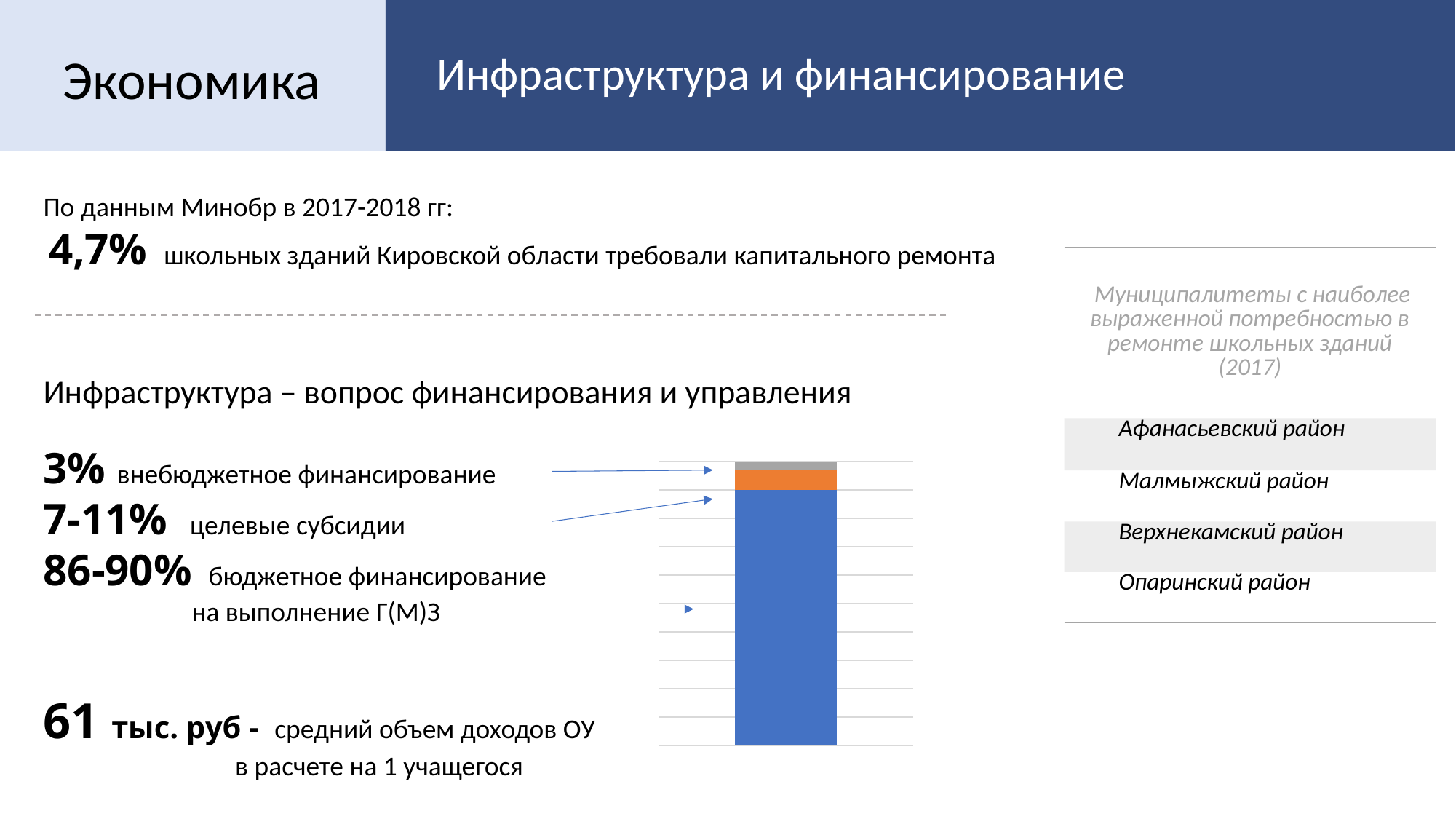
According to the annotation pointing to the blue segment of the bar, what share is бюджетное финансирование на выполнение Г(М)З? 86-90% Is the blue segment of the bar larger or smaller than the orange segment? larger What colour is the segment representing бюджетное финансирование in the chart? blue Which segment of the stacked bar is the largest? the blue segment (бюджетное финансирование) How many segments make up the stacked bar in the chart? 3 What kind of chart is shown on the slide? stacked bar chart Which segment is at the top of the stacked bar? the gray segment (внебюджетное финансирование) Which segment of the stacked bar is the smallest? the gray segment (внебюджетное финансирование) According to the annotation pointing to the orange segment of the bar, what share is целевые субсидии? 7-11% According to the annotation pointing to the top (gray) segment of the bar, what share is внебюджетное финансирование? 3%